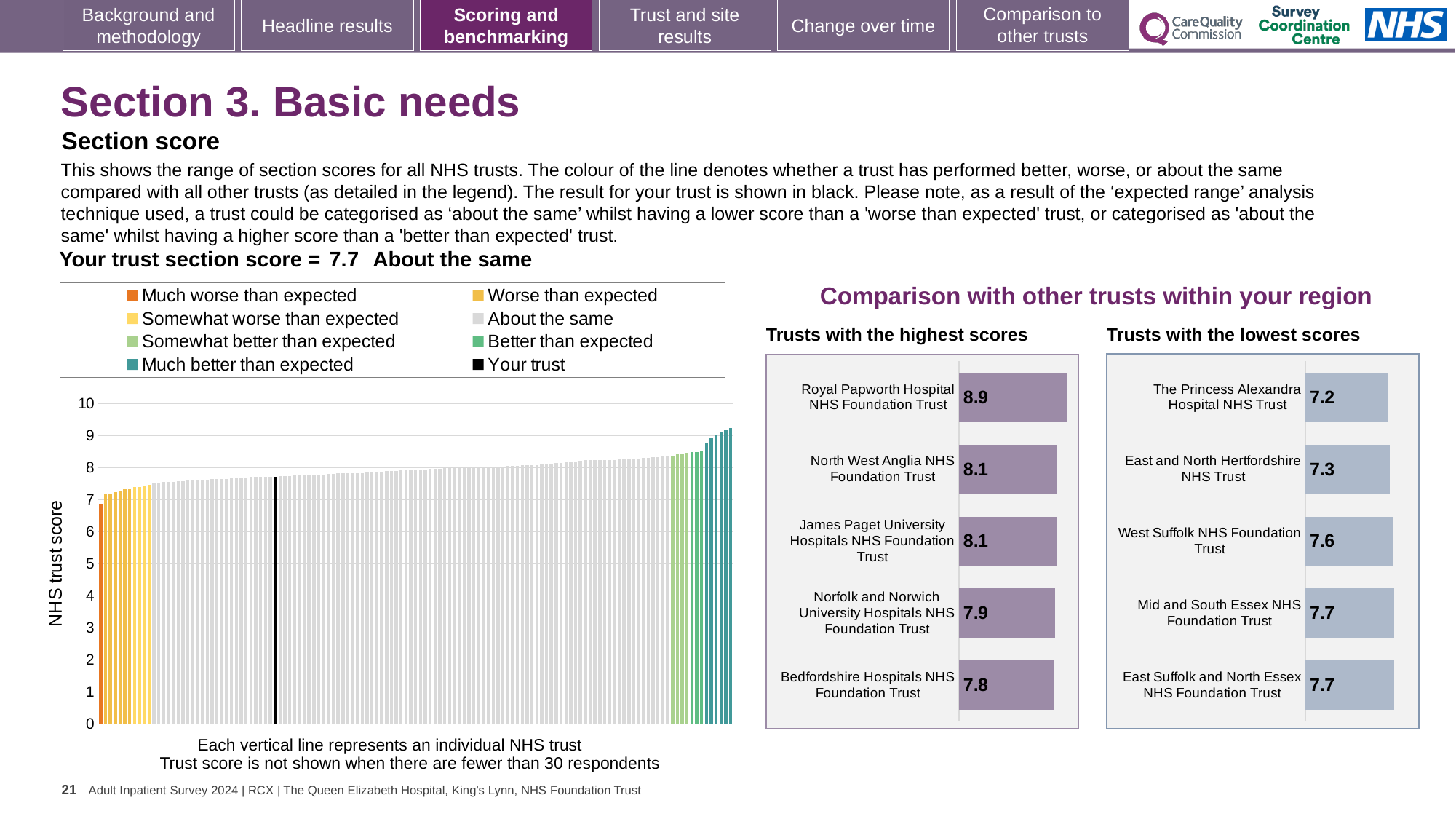
In the 'Trusts with the highest scores' chart, what is the score for Royal Papworth Hospital NHS Foundation Trust? 8.9 How many trusts are listed in the 'Trusts with the highest scores' chart? 5 In the large chart on the left, do the trust scores rise or fall from left to right along the x axis? Rise In the 'Trusts with the lowest scores' chart, what is the score for West Suffolk NHS Foundation Trust? 7.6 In the 'Trusts with the highest scores' chart, which trust has the lowest score shown? Bedfordshire Hospitals NHS Foundation Trust What is the section score for your trust shown on the slide? 7.7 In the 'Trusts with the lowest scores' chart, what is the difference between the scores of East and North Hertfordshire NHS Trust and The Princess Alexandra Hospital NHS Trust? 0.1 In the 'Trusts with the highest scores' chart, which has the higher score: North West Anglia NHS Foundation Trust or Norfolk and Norwich University Hospitals NHS Foundation Trust? North West Anglia NHS Foundation Trust What kind of chart is the large chart on the left showing NHS trust scores? Bar chart How many entries does the legend of the large chart on the left list? 8 In the 'Trusts with the highest scores' chart, what is the difference between the scores of Royal Papworth Hospital NHS Foundation Trust and Bedfordshire Hospitals NHS Foundation Trust? 1.1 In the 'Trusts with the lowest scores' chart, which trust has the lowest score? The Princess Alexandra Hospital NHS Trust